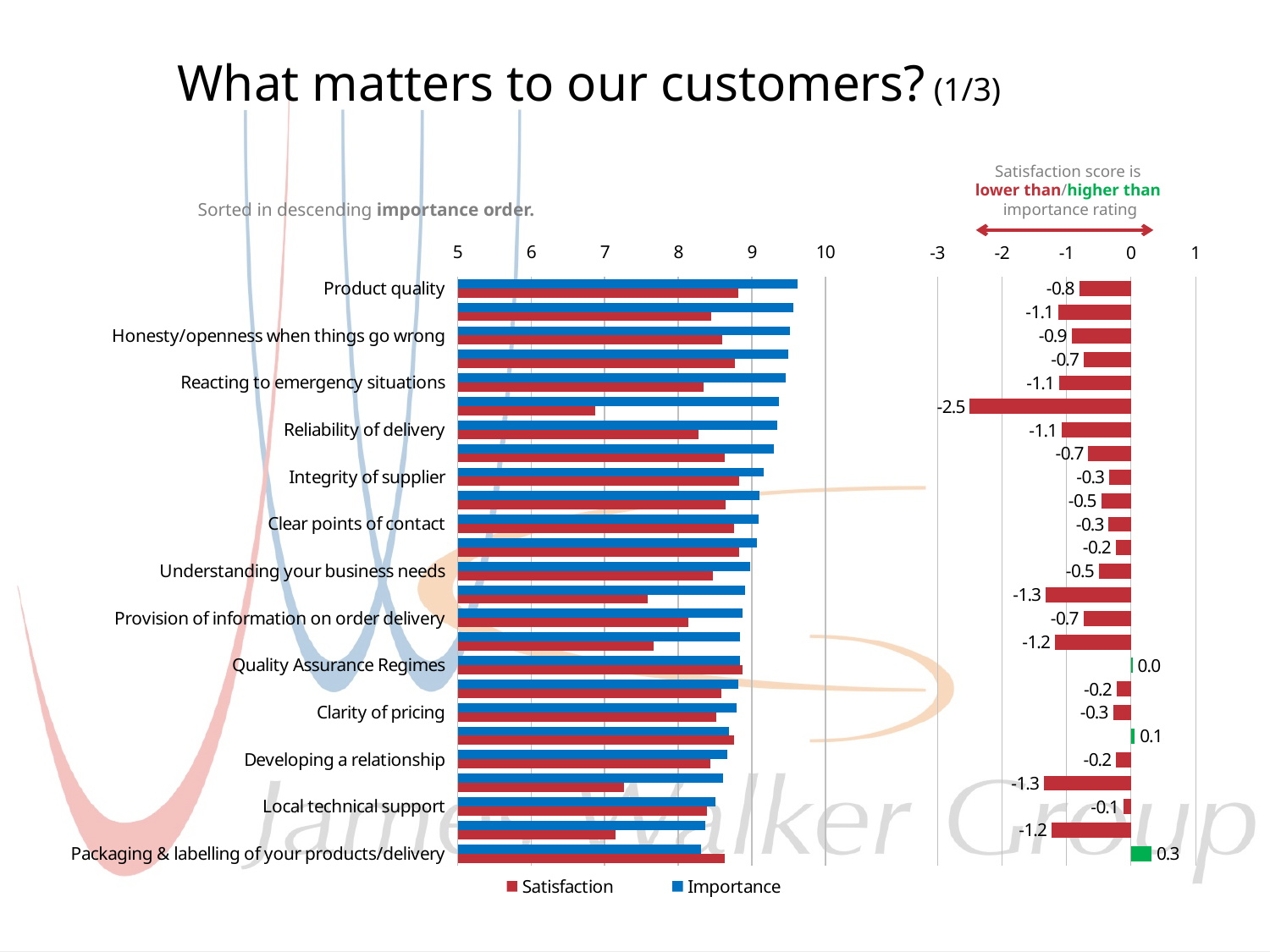
On the right-hand chart, what is the difference value shown for Product quality? -0.8 On the left-hand chart, is the Satisfaction value for Reliability of delivery greater or less than 9? less On the right-hand chart, what is the difference value shown for Packaging & labelling of your products/delivery? 0.3 On the right-hand chart, which labelled category has the highest difference value? Packaging & labelling of your products/delivery On the right-hand chart, what is the difference value shown for Reacting to emergency situations? -1.1 What kind of chart is the left-hand chart? Bar chart On the right-hand chart, what is the difference value shown for Understanding your business needs? -0.5 On the right-hand chart, what is the difference between the values for Product quality and Honesty/openness when things go wrong? 0.1 On the right-hand chart, what is the difference value shown for Quality Assurance Regimes? 0.0 On the left-hand chart, is the Importance value for Product quality greater or less than 9? greater How many series does the legend of the left-hand chart list? 2 On the left-hand chart, which is larger for Product quality, Satisfaction or Importance? Importance